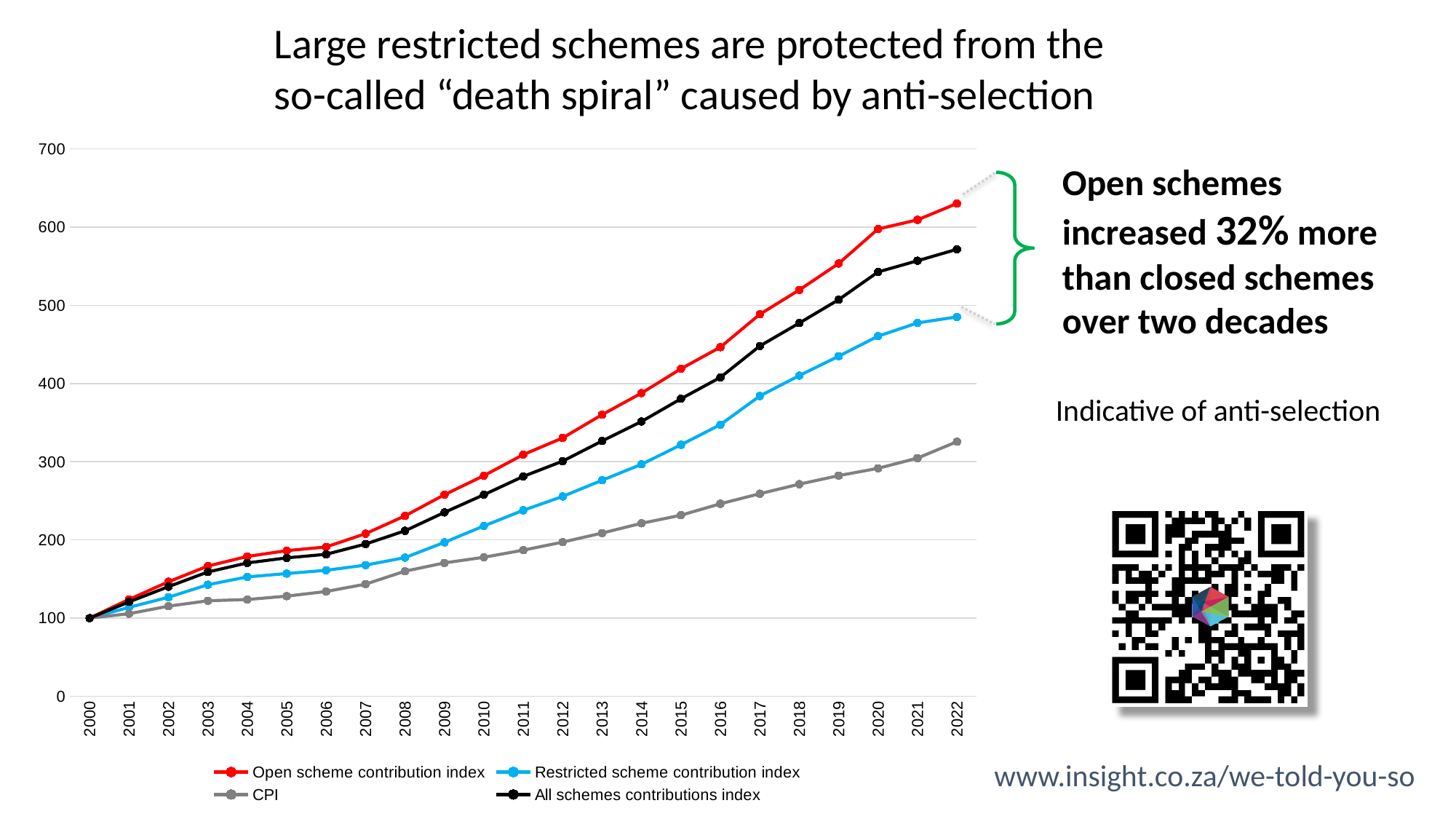
Is the value of CPI in 2022 greater or less than 300? greater In 2015, which is higher: the Restricted scheme contribution index or CPI? Restricted scheme contribution index Is the value of the All schemes contributions index in 2022 greater or less than 600? less What kind of chart is shown on the slide? Line chart Which series has the lowest value in 2022? CPI Is the value of the Restricted scheme contribution index in 2022 greater or less than 500? less How many series does the legend list? 4 Do the values of the Open scheme contribution index rise or fall from 2000 to 2022? Rise Which series has the highest value in 2022? Open scheme contribution index What is the value of the Open scheme contribution index in 2000? 100 How many years are plotted along the x axis? 23